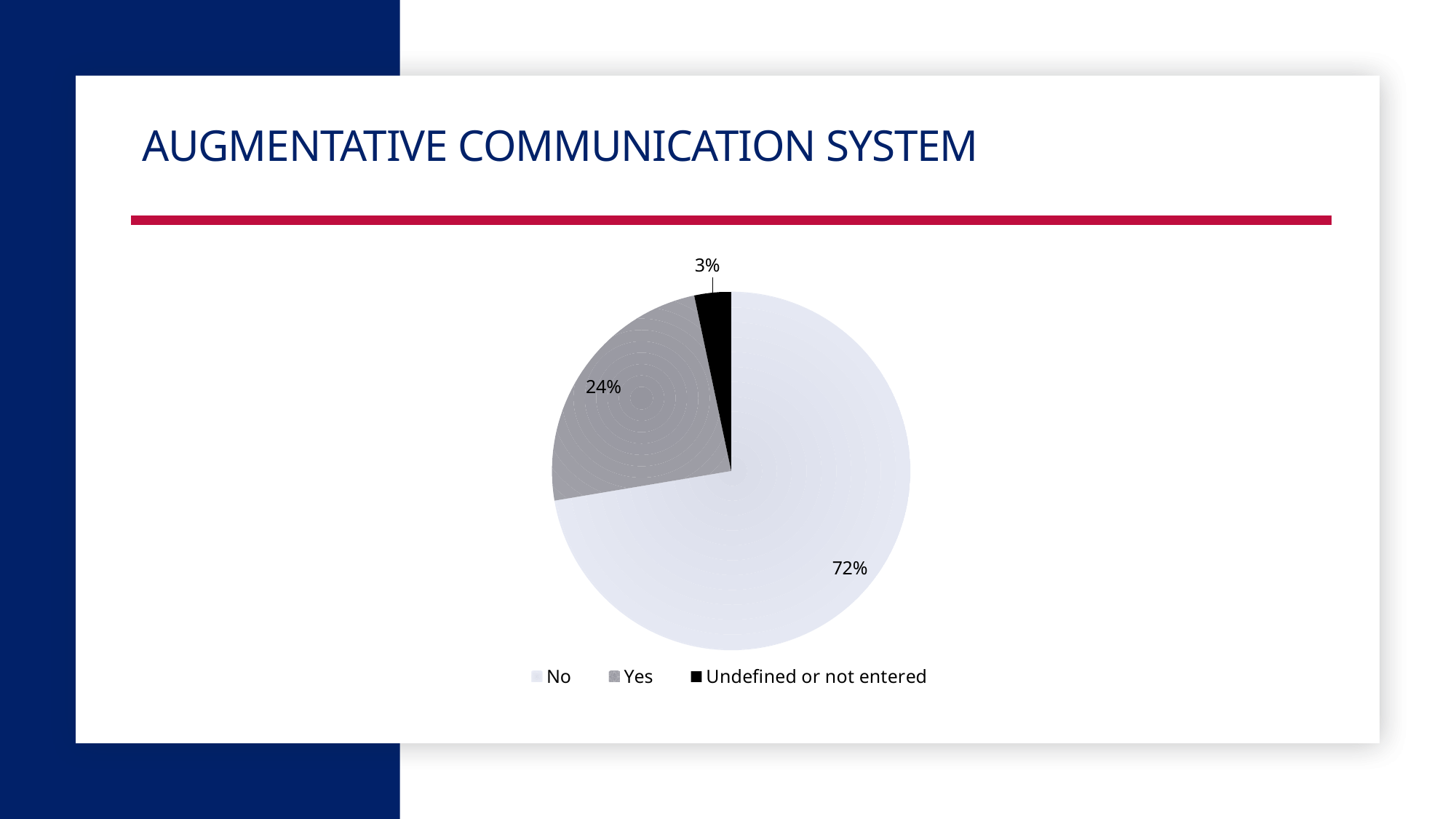
Which category has the largest slice of the pie? No What is the difference in percentage points between the "No" slice and the "Yes" slice? 48 Which legend entry is shown in black? Undefined or not entered What share of the pie does the "No" slice represent? 72% What is the difference in percentage points between the "Yes" slice and the "Undefined or not entered" slice? 21 Which category has the smallest slice of the pie? Undefined or not entered What share of the pie does the "Undefined or not entered" slice represent? 3% What is the title of the slide containing the chart? AUGMENTATIVE COMMUNICATION SYSTEM What kind of chart is shown on the slide? Pie chart What share of the pie does the "Yes" slice represent? 24% Which is larger, the "Yes" slice or the "Undefined or not entered" slice? Yes How many slices does the pie chart have? 3